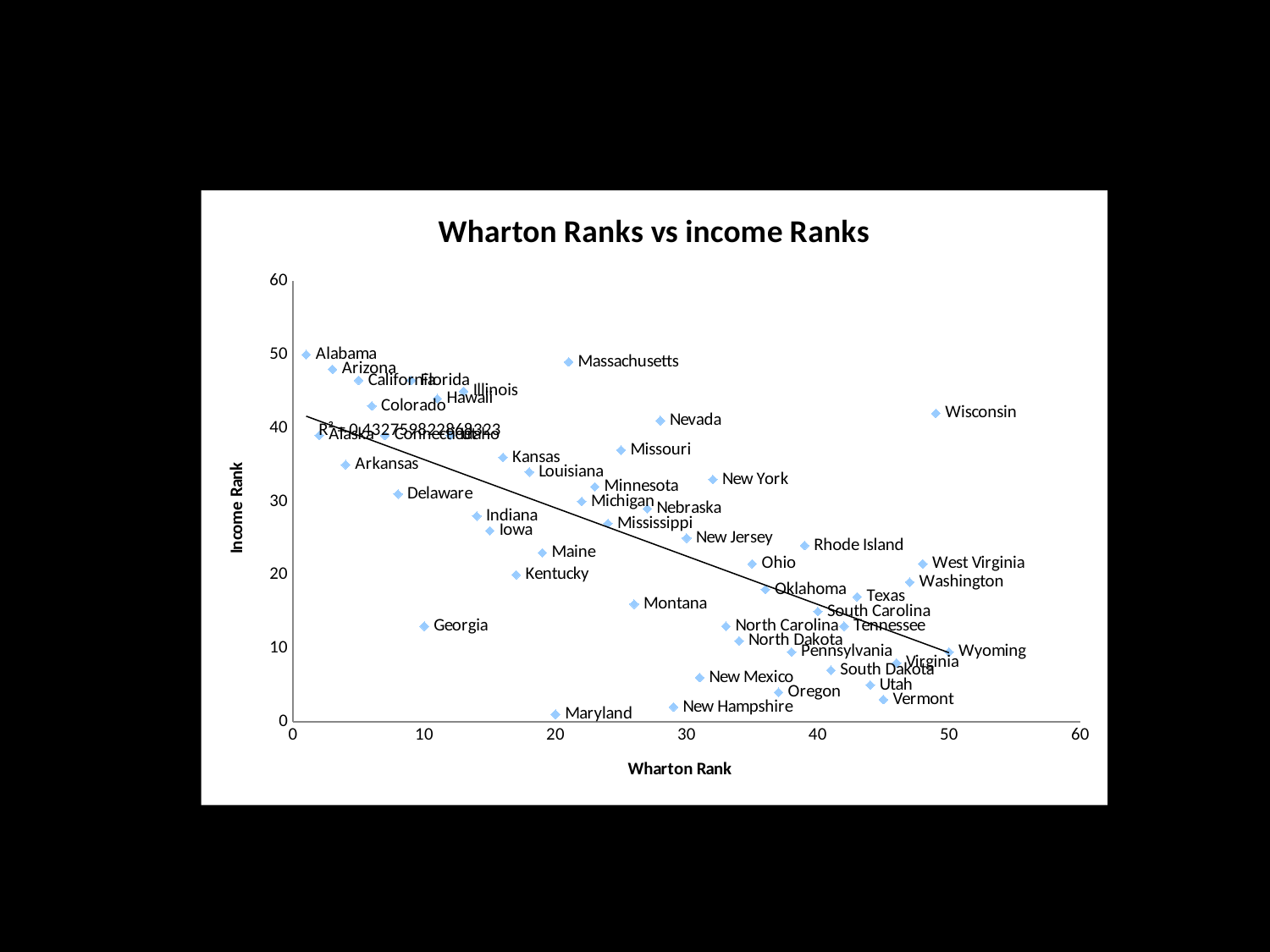
Does the trend line rise or fall as Wharton Rank increases? falls Is the Income Rank for Massachusetts greater or less than 40? greater Is the Wharton Rank for Wyoming greater or less than 40? greater Is the Wharton Rank for Georgia greater or less than 20? less What kind of chart is shown on the slide? scatter chart Which state has the higher Income Rank, Alabama or Maryland? Alabama Which state has the higher Wharton Rank, Wisconsin or Georgia? Wisconsin What is the title of the chart? Wharton Ranks vs income Ranks What is the label of the vertical axis? Income Rank